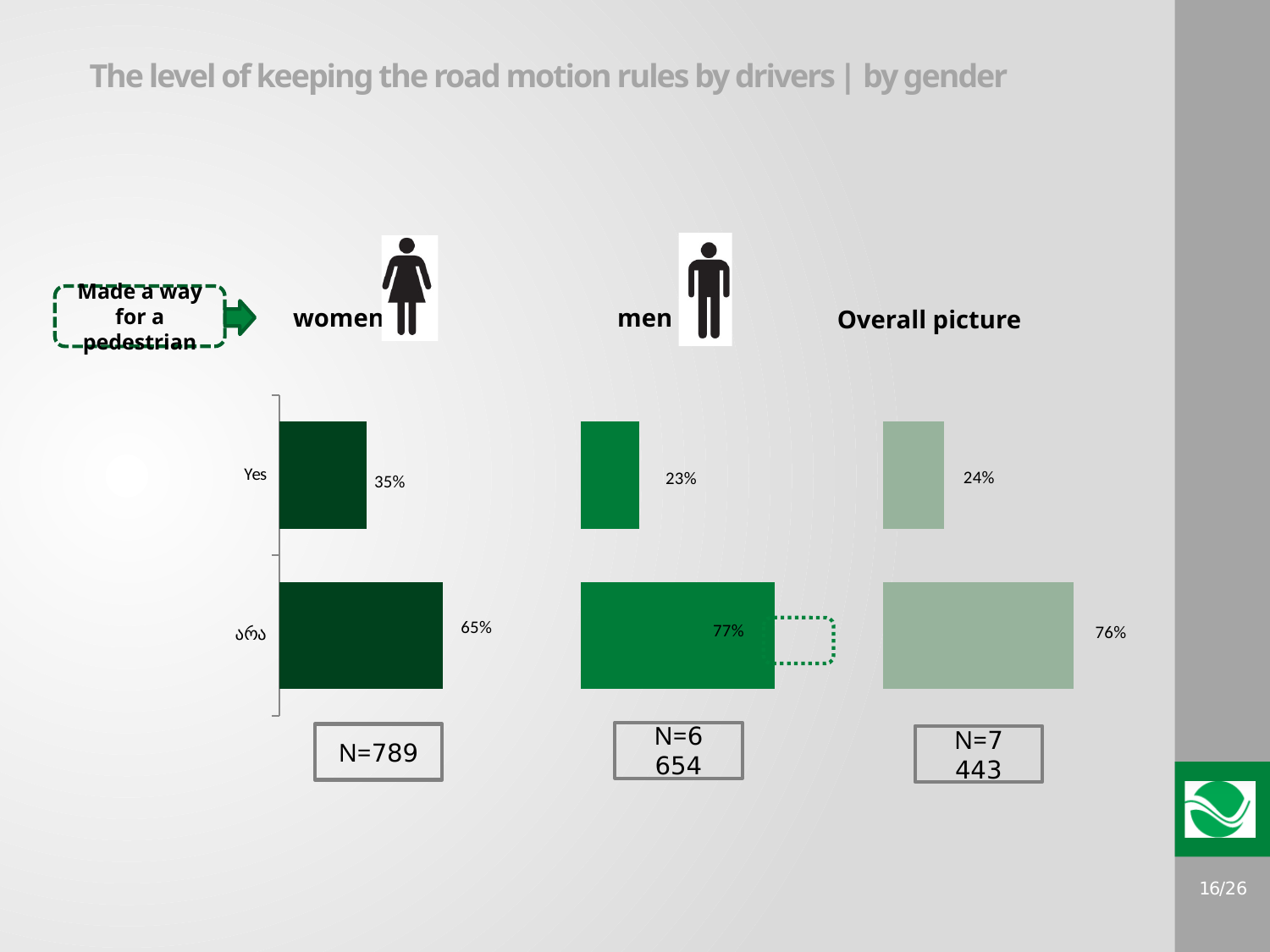
In the women chart, what is the value for the category labelled არა? 65% In the Overall picture chart, what is the value for Yes? 24% In the women chart, what is the value for Yes? 35% In the women chart, which category has the lowest value? Yes What is the sample size (N) shown under the women chart? N=789 What kind of chart is the Overall picture chart? bar chart How many categories does the men chart show? 2 In the women chart, what is the difference between the არა value and the Yes value? 30% In the Overall picture chart, which category has the highest value? არა In the men chart, what is the value for the category labelled არა? 77% Is the Yes value larger in the women chart or in the men chart? women In the men chart, what is the value for Yes? 23%